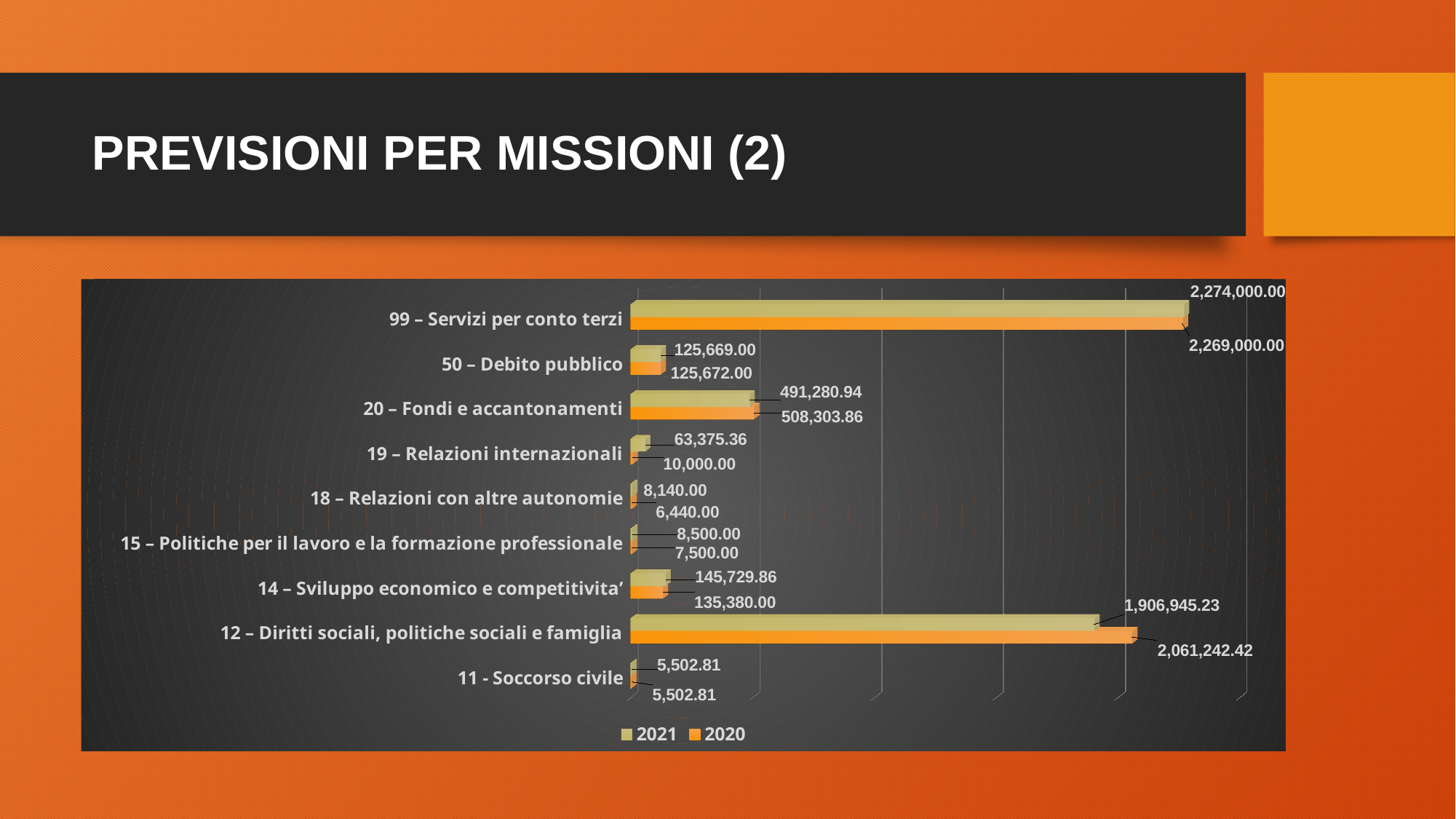
What is the 2021 value for 19 – Relazioni internazionali? 63,375.36 Which category has the highest 2021 value? 99 – Servizi per conto terzi Which category has the lowest 2020 value? 11 - Soccorso civile For 20 – Fondi e accantonamenti, which year has the larger value, 2020 or 2021? 2020 What is the difference between the 2021 and 2020 values for 19 – Relazioni internazionali? 53,375.36 What is the difference between the 2020 and 2021 values for 12 – Diritti sociali, politiche sociali e famiglia? 154,297.19 What is the 2020 value for 20 – Fondi e accantonamenti? 508,303.86 How many series does the legend list? 2 What is the 2021 value for 99 – Servizi per conto terzi? 2,274,000.00 What is the 2020 value for 12 – Diritti sociali, politiche sociali e famiglia? 2,061,242.42 How many categories are shown in the chart? 9 What kind of chart is shown on the slide? Bar chart